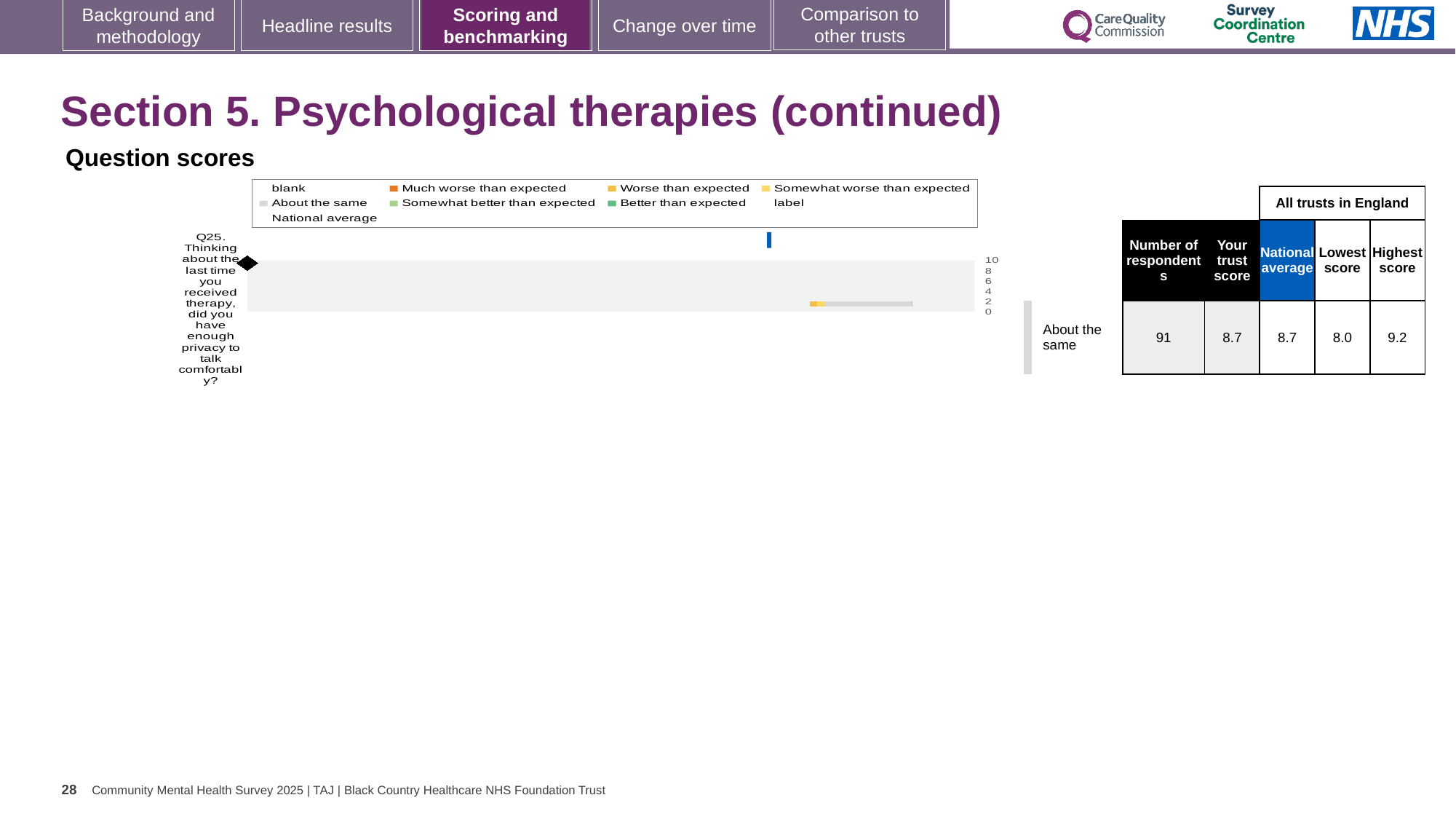
What is the highest value shown on the chart's score axis? 10 Which is larger for Q25: the highest score in England or the trust's own score? Highest score In the table next to the chart, what is the national average for Q25? 8.7 Which question is plotted in the Question scores chart? Q25 What is the difference between the highest and lowest trust scores for Q25 shown in the table? 1.2 In the table next to the chart, what is the trust's score for Q25? 8.7 What benchmark category is given for Q25 next to the chart? About the same In the table next to the chart, what is the lowest score among all trusts in England for Q25? 8.0 In the table next to the chart, what is the number of respondents for Q25? 91 How many questions are plotted in the Question scores chart? 1 What kind of chart is shown under 'Question scores'? bar chart In the table next to the chart, what is the highest score among all trusts in England for Q25? 9.2